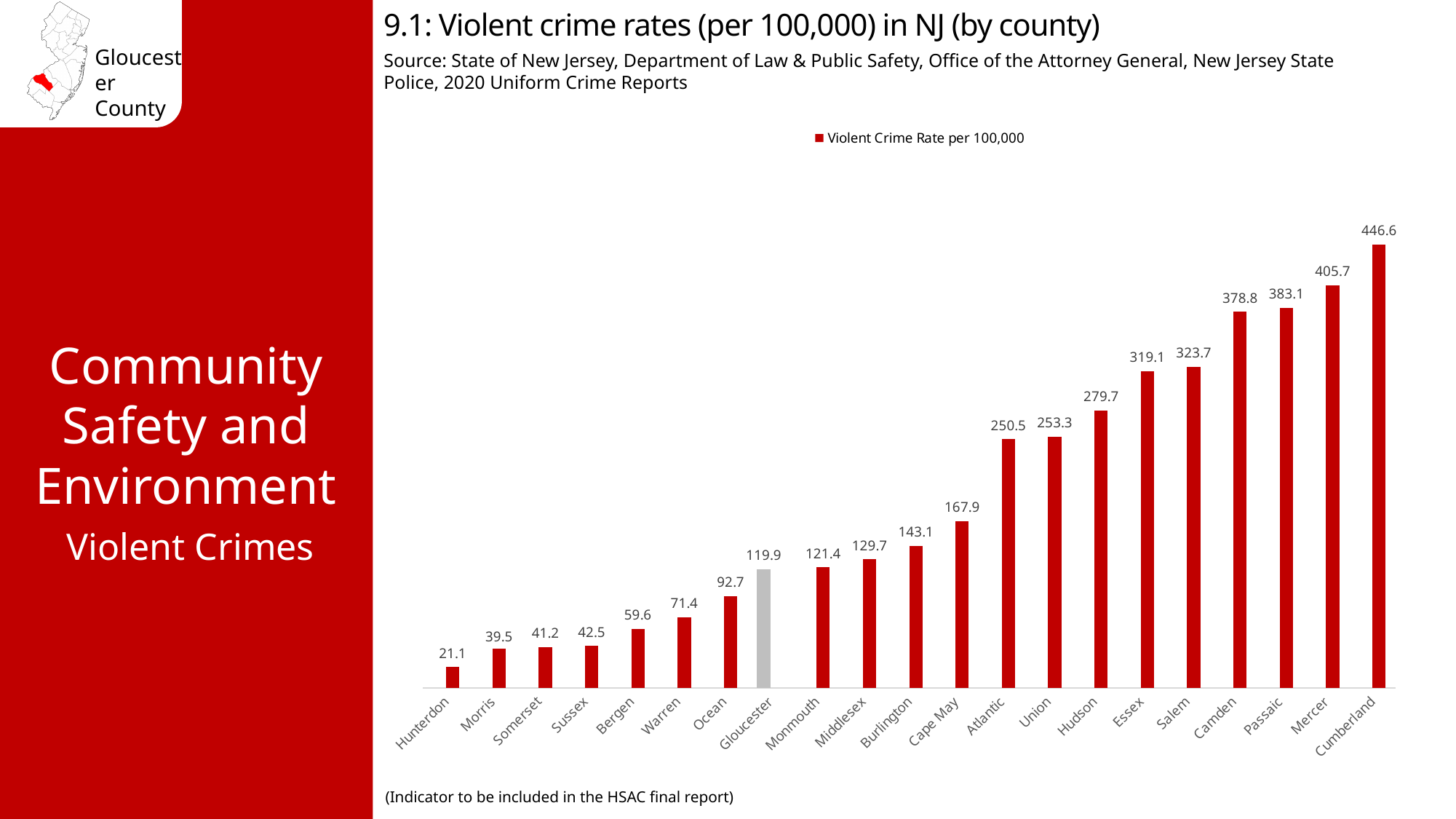
Which has a higher violent crime rate, Essex or Atlantic? Essex Do the violent crime rates rise or fall from left to right along the x axis? Rise What is the difference between the violent crime rates of Gloucester and Ocean? 27.2 What is the difference between the violent crime rates of Cumberland and Hunterdon? 425.5 Which county has the highest violent crime rate? Cumberland What is the violent crime rate per 100,000 for Hudson? 279.7 How many series does the legend list? 1 What is the violent crime rate per 100,000 for Cape May? 167.9 Which county has the lowest violent crime rate? Hunterdon How many counties are shown on the chart? 21 What is the violent crime rate per 100,000 for Gloucester County? 119.9 What kind of chart is shown on the slide? Bar chart